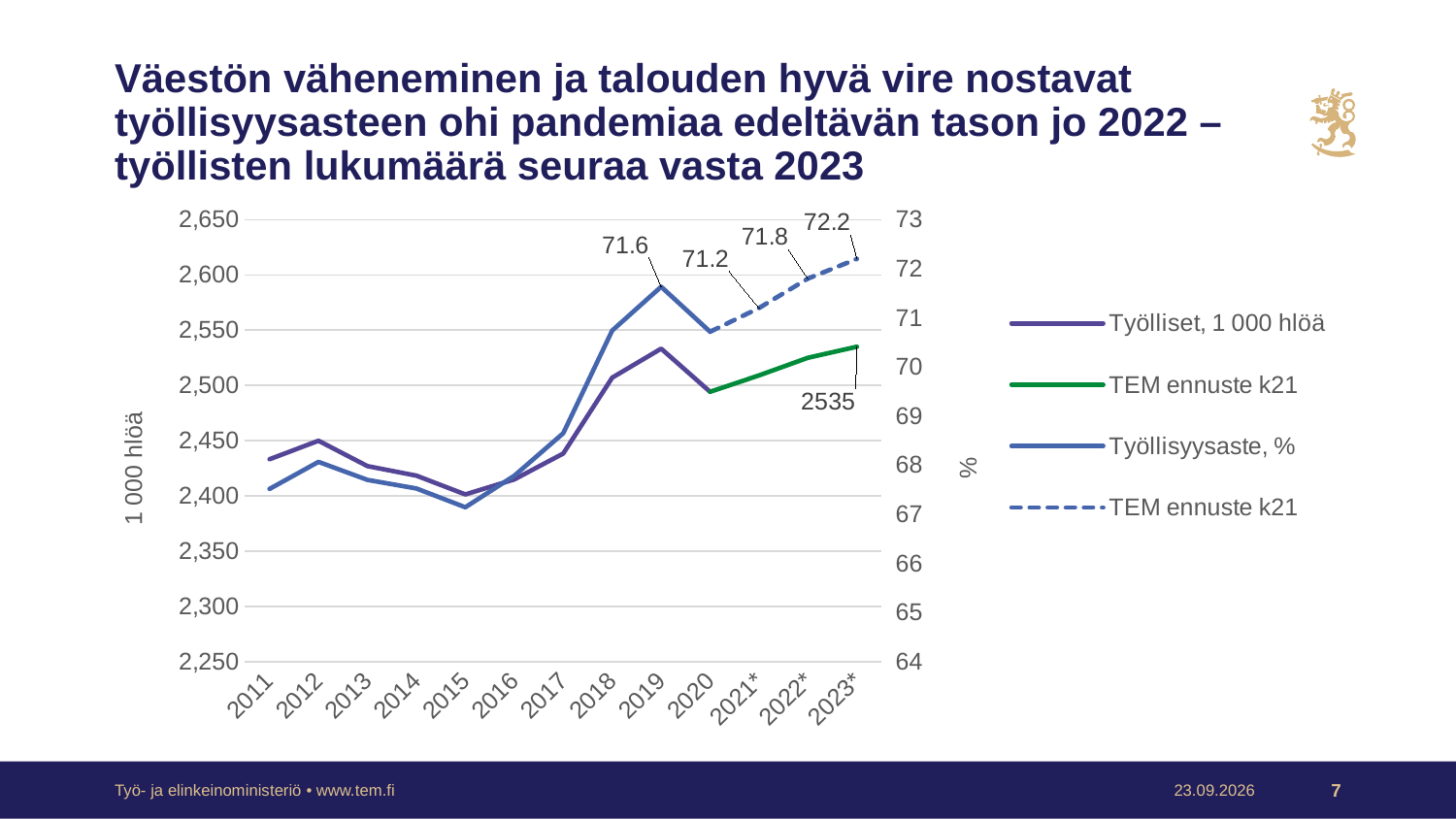
By how many percentage points does the labelled employment rate for 2023* exceed the labelled rate for 2019? 0.6 What is the employment rate (Työllisyysaste, %) shown for 2019? 71.6 Which year has the higher employment rate, 2019 or 2020? 2019 What is the forecast number of employed persons (TEM ennuste k21, 1 000 hlöä) labelled for 2023*? 2535 How many series does the chart legend list? 4 Is the value of Työlliset, 1 000 hlöä for 2019 greater or less than 2,500? greater How many years are shown on the x axis of the chart? 13 What is the forecast employment rate (TEM ennuste k21) labelled for 2023*? 72.2 Is the value of Työlliset, 1 000 hlöä for 2015 greater or less than 2,450? less What type of chart is shown on the slide? Line chart